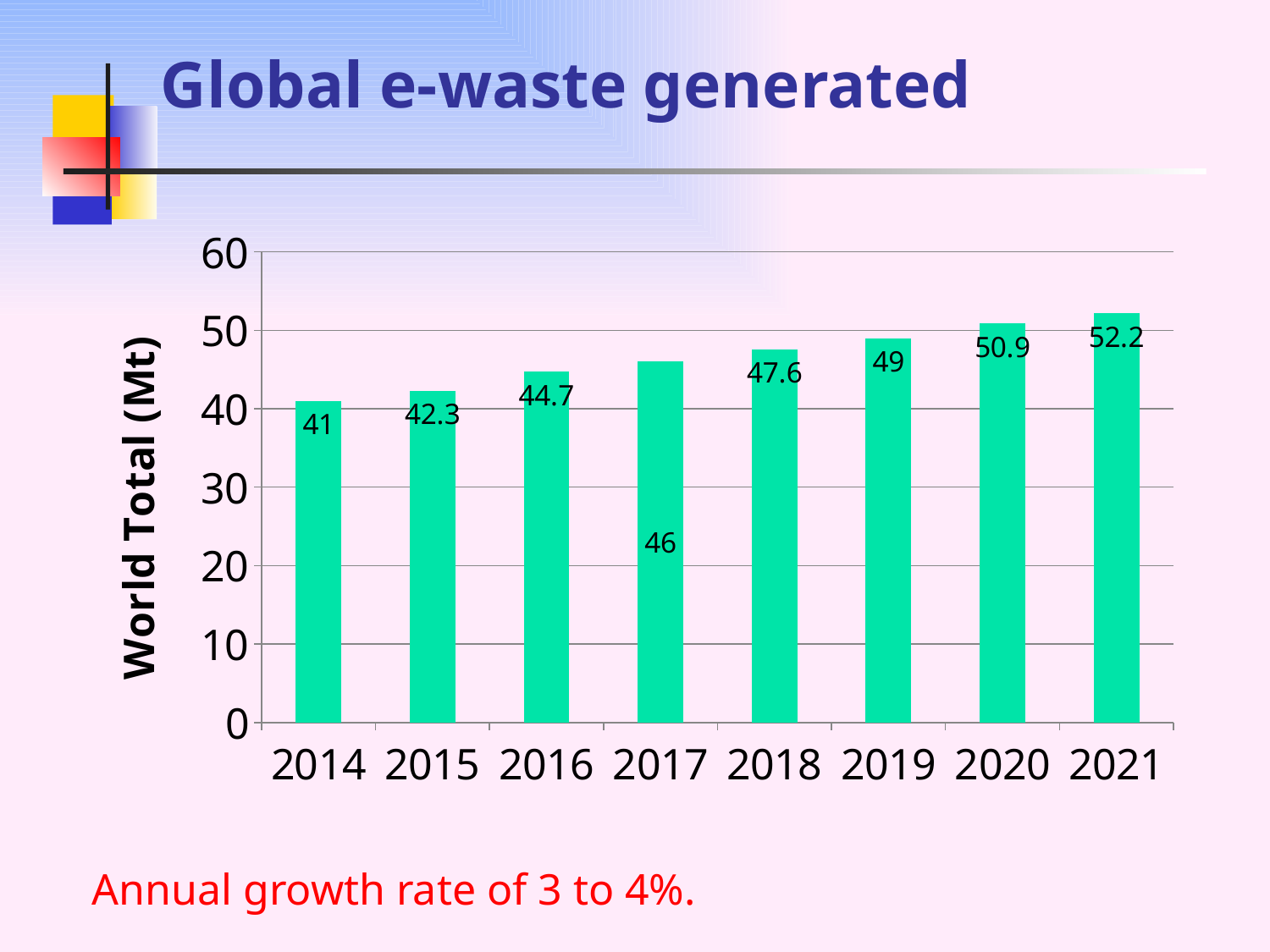
Do the values rise or fall from 2014 to 2021? rise What is the world total of e-waste generated in 2017? 46 What is the difference between the world total in 2021 and in 2014? 11.2 How many years are shown on the x axis of the chart? 8 Is the value for 2021 greater or less than 50? greater What is the world total of e-waste generated in 2020? 50.9 Which year has a larger world total, 2016 or 2018? 2018 What is the difference between the world total in 2019 and in 2018? 1.4 Which year has the lowest world total of e-waste generated? 2014 Which year has the highest world total of e-waste generated? 2021 What kind of chart is shown on the slide? bar chart What is the world total of e-waste generated in 2014? 41